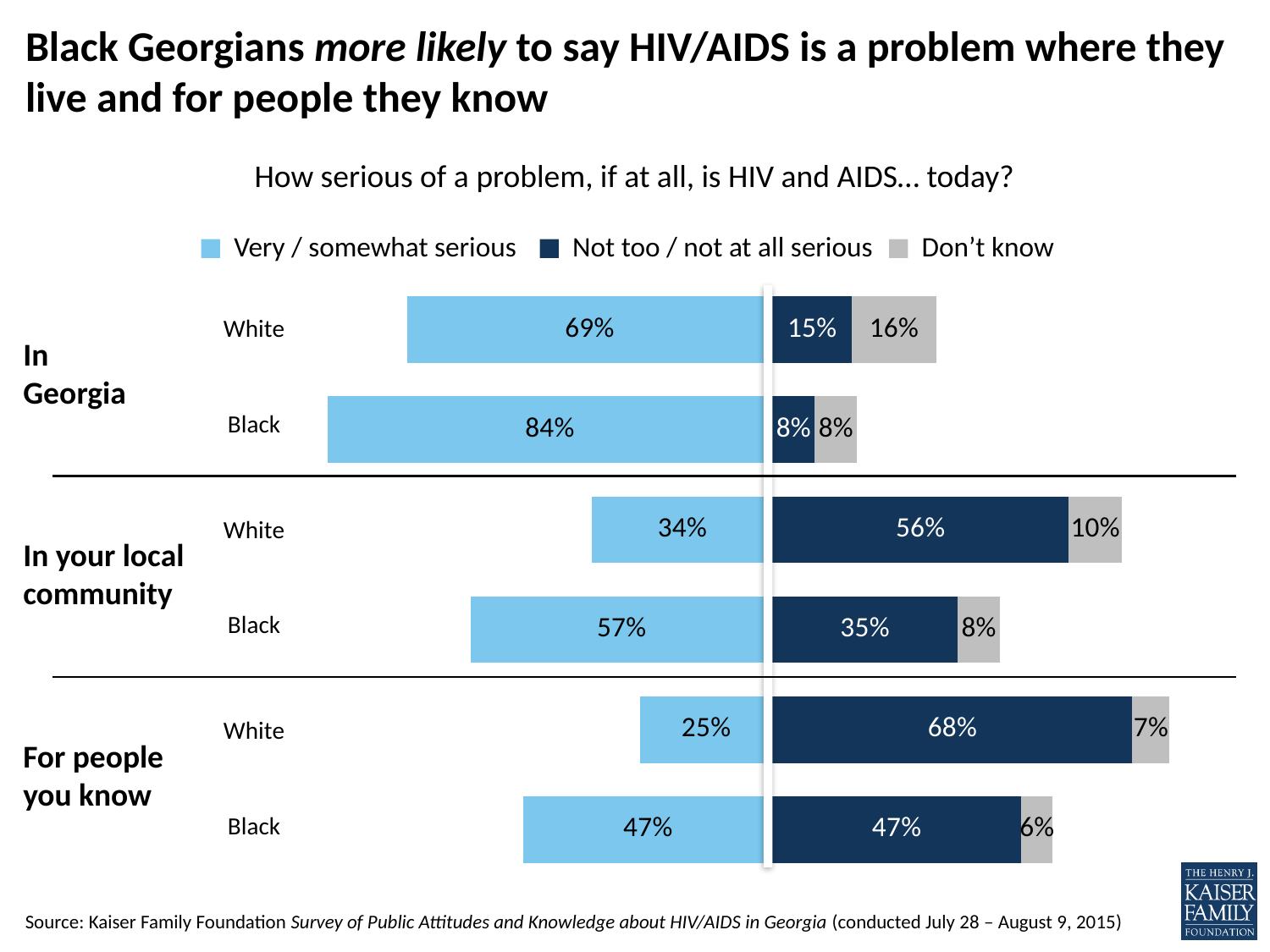
Which is larger: the 'Not too / not at all serious' share for White respondents in Georgia or for Black respondents in Georgia? White What percentage of White respondents say HIV/AIDS is not too or not at all serious for people they know? 68% How many series does the legend list? 3 What kind of chart is shown on the slide? Stacked bar chart What percentage of White respondents say HIV/AIDS is a very or somewhat serious problem in Georgia? 69% Which group and race has the lowest 'Very / somewhat serious' percentage? White, For people you know Which group and race has the highest 'Very / somewhat serious' percentage? Black, In Georgia What is the 'Don't know' percentage for White respondents in the 'In Georgia' group? 16% What colour represents the 'Don't know' series? Grey How many bars are shown in the chart? 6 What percentage of Black respondents say HIV/AIDS is a very or somewhat serious problem in their local community? 57% What is the difference between Black and White respondents' 'Very / somewhat serious' percentages for the local community? 23%